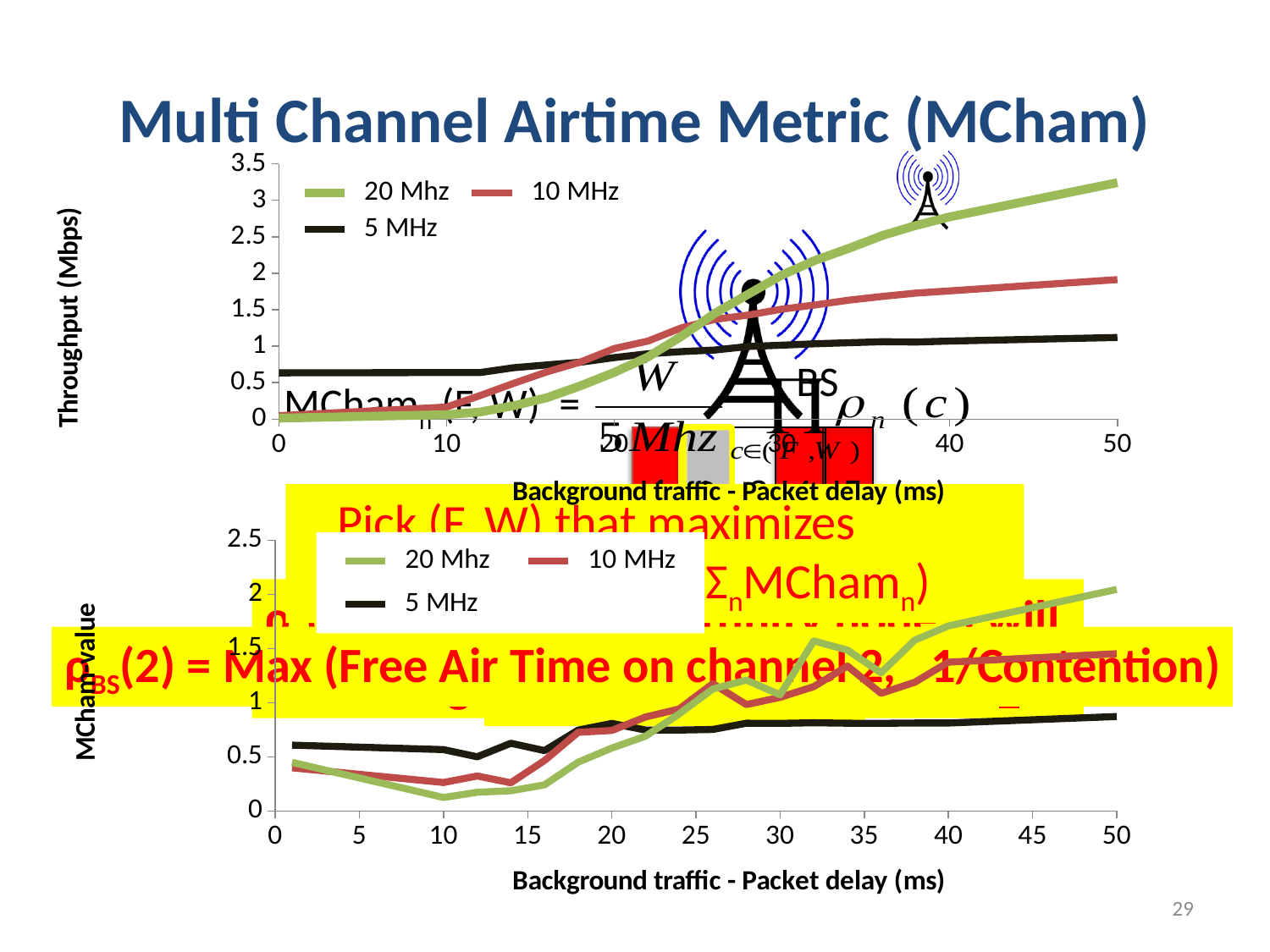
In the top chart, does the throughput of the 20 Mhz series rise or fall as packet delay increases? rise In the top chart, which series has the highest throughput at a packet delay of 50 ms? 20 Mhz In the top chart, is the throughput of the 5 MHz series at 0 ms greater or less than 1? less What kind of chart is the top chart (Throughput vs Background traffic - Packet delay)? line chart In the bottom chart, is the MCham-value of the 5 MHz series at 50 ms greater or less than 1? less In the top chart, which series has the higher throughput at a packet delay of 0 ms: 5 MHz or 20 Mhz? 5 MHz How many series does the legend of the top chart list? 3 What is the x-axis title of the bottom chart? Background traffic - Packet delay (ms) In the top chart, is the throughput of the 20 Mhz series at 50 ms greater or less than 3? greater In the bottom chart, which series has the higher MCham-value at a packet delay of 10 ms: 5 MHz or 20 Mhz? 5 MHz In the bottom chart, which series has the highest MCham-value at a packet delay of 50 ms? 20 Mhz In the top chart, which series has the lowest throughput at a packet delay of 50 ms? 5 MHz